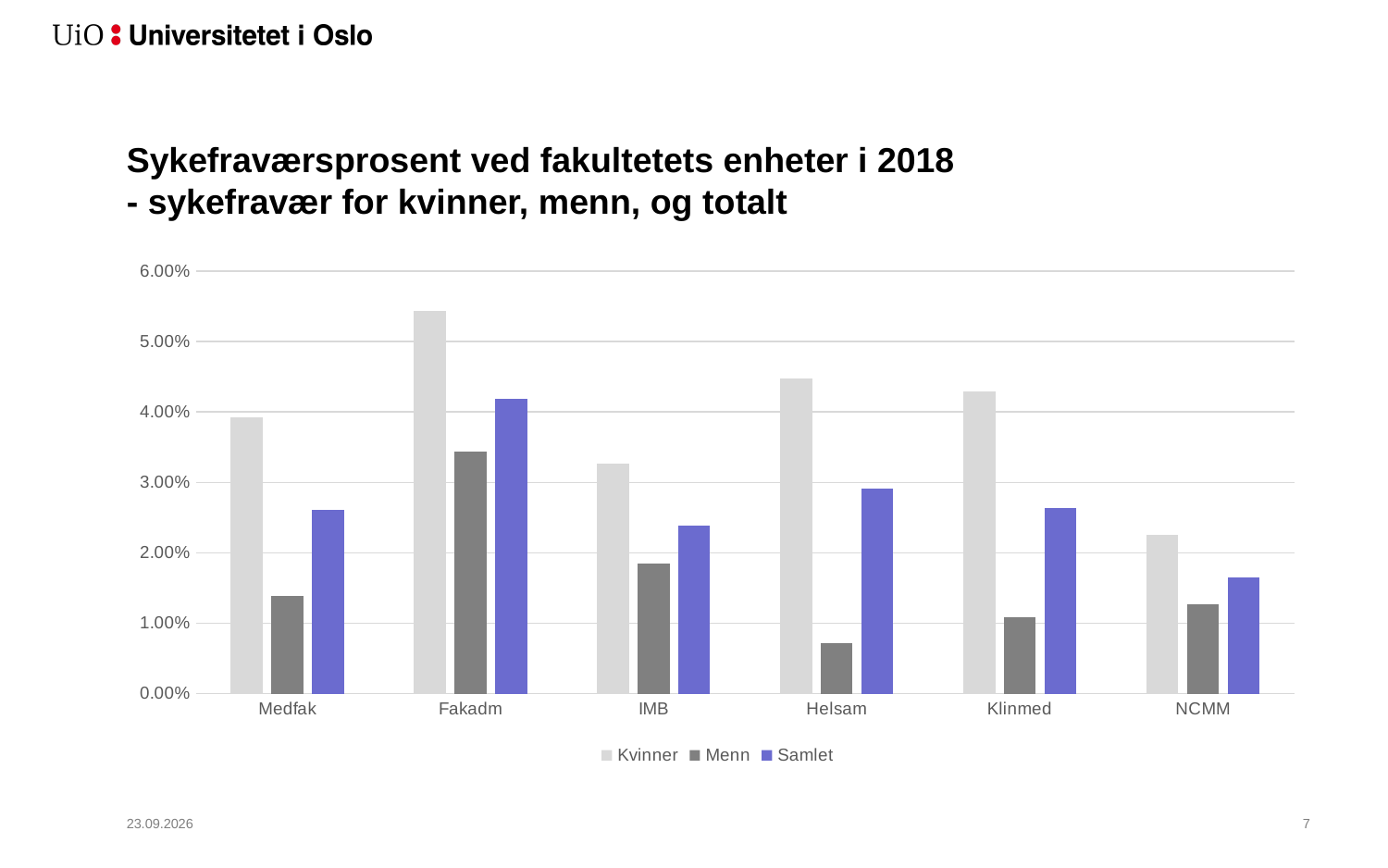
How many series does the legend list? 3 Which is larger, the Samlet value for Helsam or the Samlet value for IMB? Helsam Which unit has the lowest Menn value? Helsam Is the Samlet value for NCMM greater or less than 2.00%? less How many units (categories) are shown on the x axis? 6 Which unit has the highest Samlet value? Fakadm Which unit has the lowest Kvinner value? NCMM Is the Kvinner value for Fakadm greater or less than 5.00%? greater Is the Menn value for Helsam greater or less than 1.00%? less What kind of chart is shown on the slide? bar chart What are the three series listed in the legend? Kvinner, Menn, Samlet Which unit has the highest Kvinner value? Fakadm